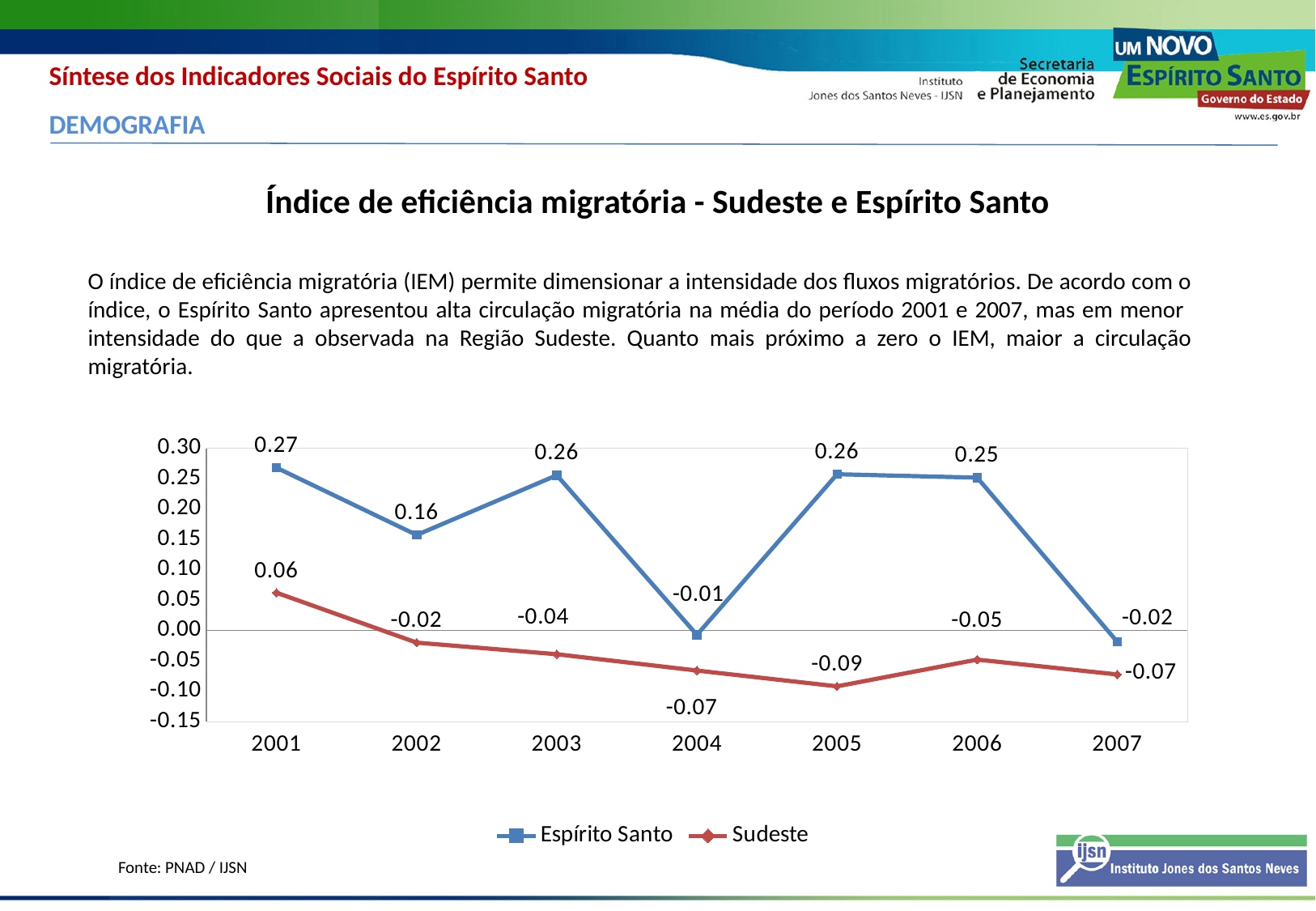
What is the value for Sudeste in 2001? 0.06 How many series does the legend list? 2 What kind of chart is shown on the slide? Line chart What is the value for Espírito Santo in 2001? 0.27 What is the value for Espírito Santo in 2004? -0.01 How many years are shown on the x axis? 7 What is the value for Sudeste in 2005? -0.09 What is the difference between the Espírito Santo and Sudeste values in 2003? 0.30 Does the Sudeste value rise or fall from 2001 to 2005? Fall In which year is the Sudeste value lowest? 2005 In which year is the Espírito Santo value highest? 2001 Which series has the larger value in 2006, Espírito Santo or Sudeste? Espírito Santo